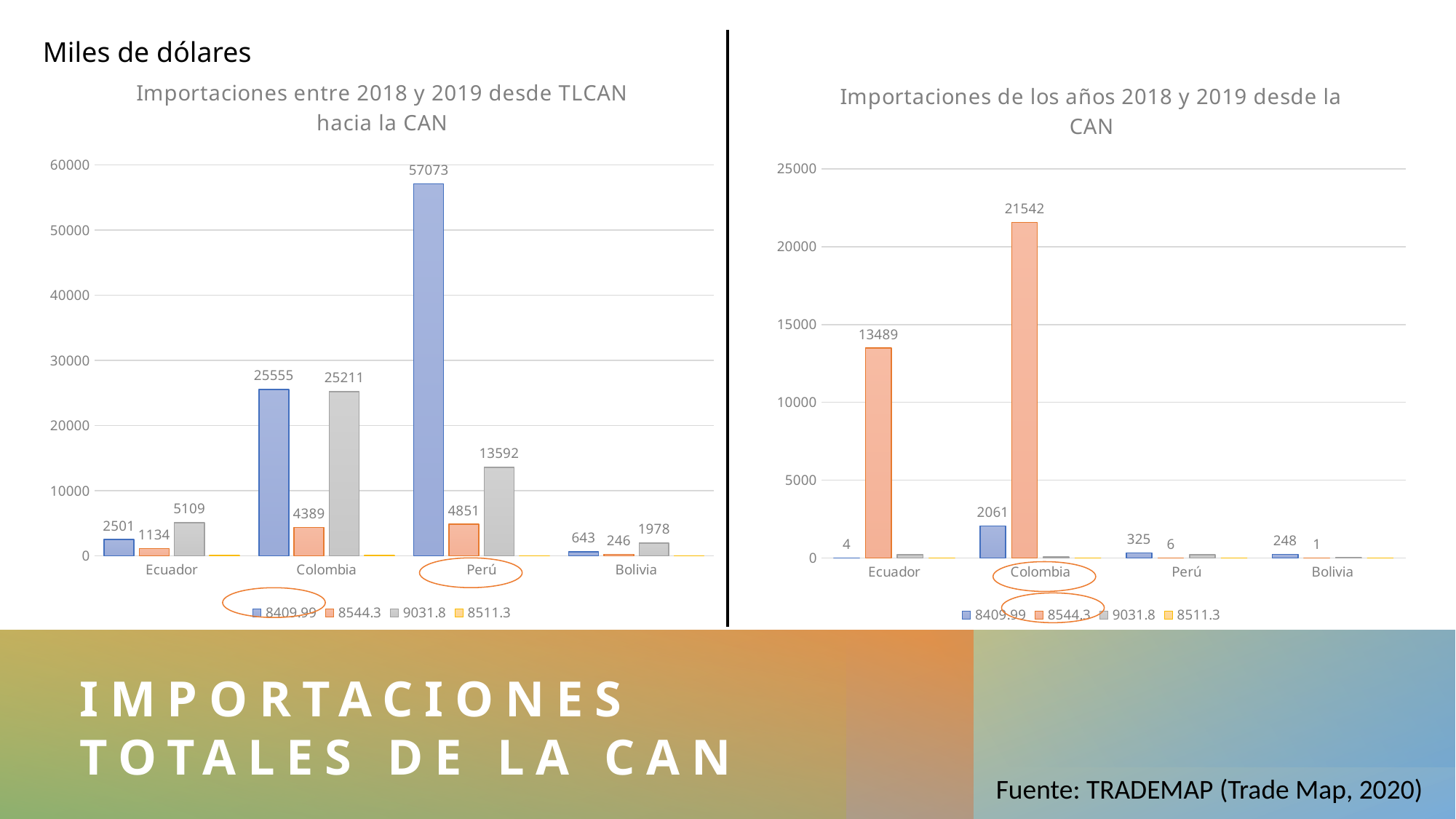
In the right chart (Importaciones de los años 2018 y 2019 desde la CAN), how many countries are shown on the x axis? 4 In the left chart (Importaciones entre 2018 y 2019 desde TLCAN hacia la CAN), how many series does the legend list? 4 In the right chart (Importaciones de los años 2018 y 2019 desde la CAN), what is the value of series 8409.99 for Ecuador? 4 In the left chart (Importaciones entre 2018 y 2019 desde TLCAN hacia la CAN), which country has the highest value for series 8409.99? Perú In the right chart (Importaciones de los años 2018 y 2019 desde la CAN), which country has the highest value for series 8544.3? Colombia In the left chart (Importaciones entre 2018 y 2019 desde TLCAN hacia la CAN), which country has the lowest value for series 8544.3? Bolivia In the left chart (Importaciones entre 2018 y 2019 desde TLCAN hacia la CAN), what is the value of series 8409.99 for Perú? 57073 What kind of chart is the right chart (Importaciones de los años 2018 y 2019 desde la CAN)? Bar chart In the left chart (Importaciones entre 2018 y 2019 desde TLCAN hacia la CAN), what is the value of series 9031.8 for Colombia? 25211 In the right chart (Importaciones de los años 2018 y 2019 desde la CAN), what is the value of series 8544.3 for Colombia? 21542 In the right chart (Importaciones de los años 2018 y 2019 desde la CAN), is the 8544.3 value for Ecuador greater or less than 10000? greater In the left chart (Importaciones entre 2018 y 2019 desde TLCAN hacia la CAN), what is the difference between the 8409.99 value for Colombia and the 8544.3 value for Colombia? 21166